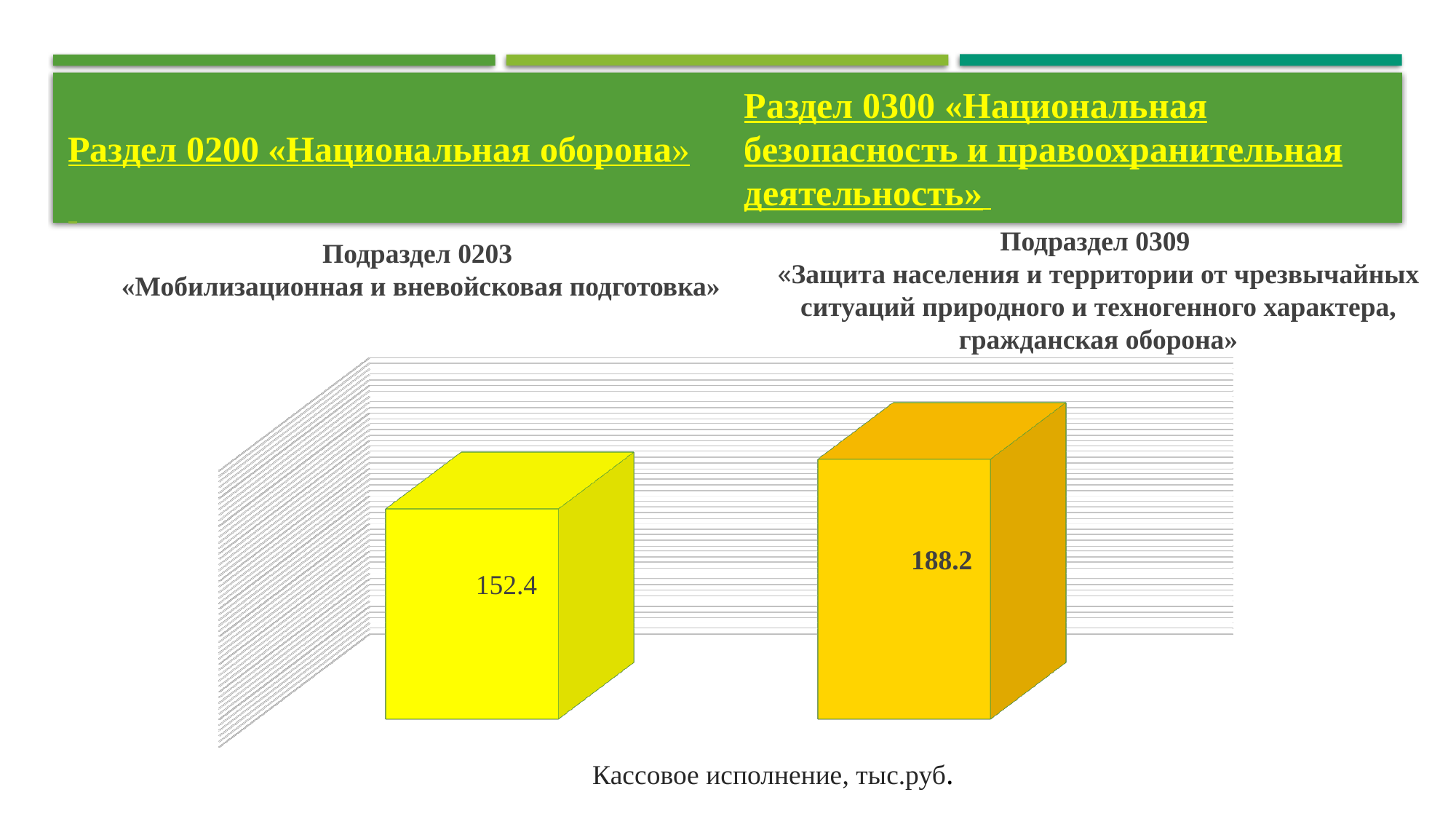
What kind of chart is shown on the slide? bar chart What is the value shown for Подраздел 0309 «Защита населения и территории от чрезвычайных ситуаций природного и техногенного характера, гражданская оборона»? 188.2 What colour is the bar for Подраздел 0203? yellow What is the value shown for Подраздел 0203 «Мобилизационная и вневойсковая подготовка»? 152.4 Which subsection has the higher cash execution value? Подраздел 0309 What is the total of the two values plotted on the chart? 340.6 What unit of measurement is given in the caption below the chart? тыс.руб. What is the difference between the values for Подраздел 0309 and Подраздел 0203? 35.8 Which subsection has the lower cash execution value? Подраздел 0203 How many bars are plotted on the chart? 2 Is the value for Подраздел 0203 larger or smaller than the value for Подраздел 0309? smaller